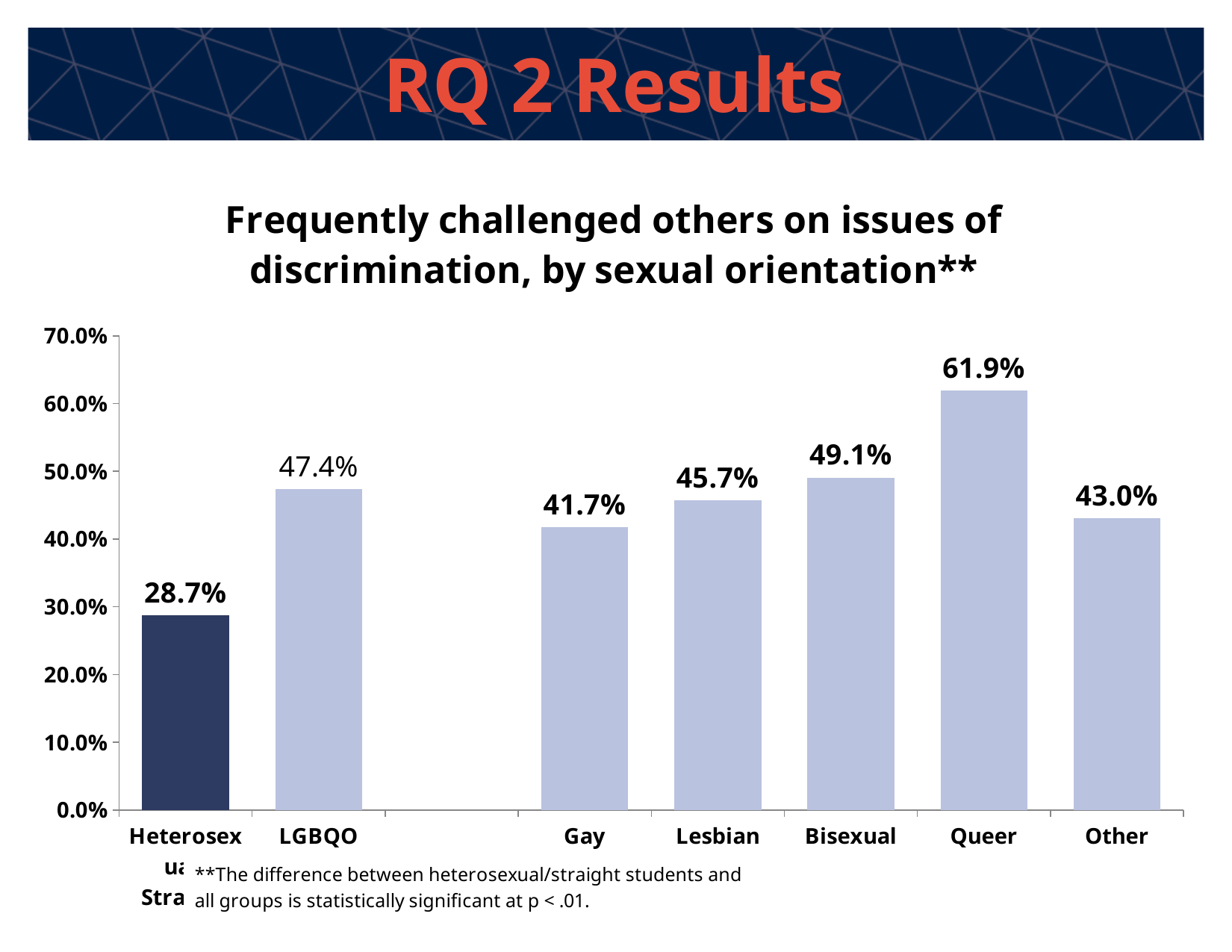
What is the difference between the values for Bisexual and Lesbian? 3.4% What is the value for LGBQO? 47.4% What is the value for Bisexual? 49.1% What is the value for Gay? 41.7% What is the value for Queer? 61.9% Which category has the lowest value? Heterosexual/Straight Which is larger, the value for Lesbian or the value for Other? Lesbian Which category has the highest value? Queer What is the title of the chart? Frequently challenged others on issues of discrimination, by sexual orientation** How many bars are plotted in the chart? 7 What kind of chart is shown on the slide? Bar chart What is the difference between the values for Queer and Heterosexual/Straight? 33.2%